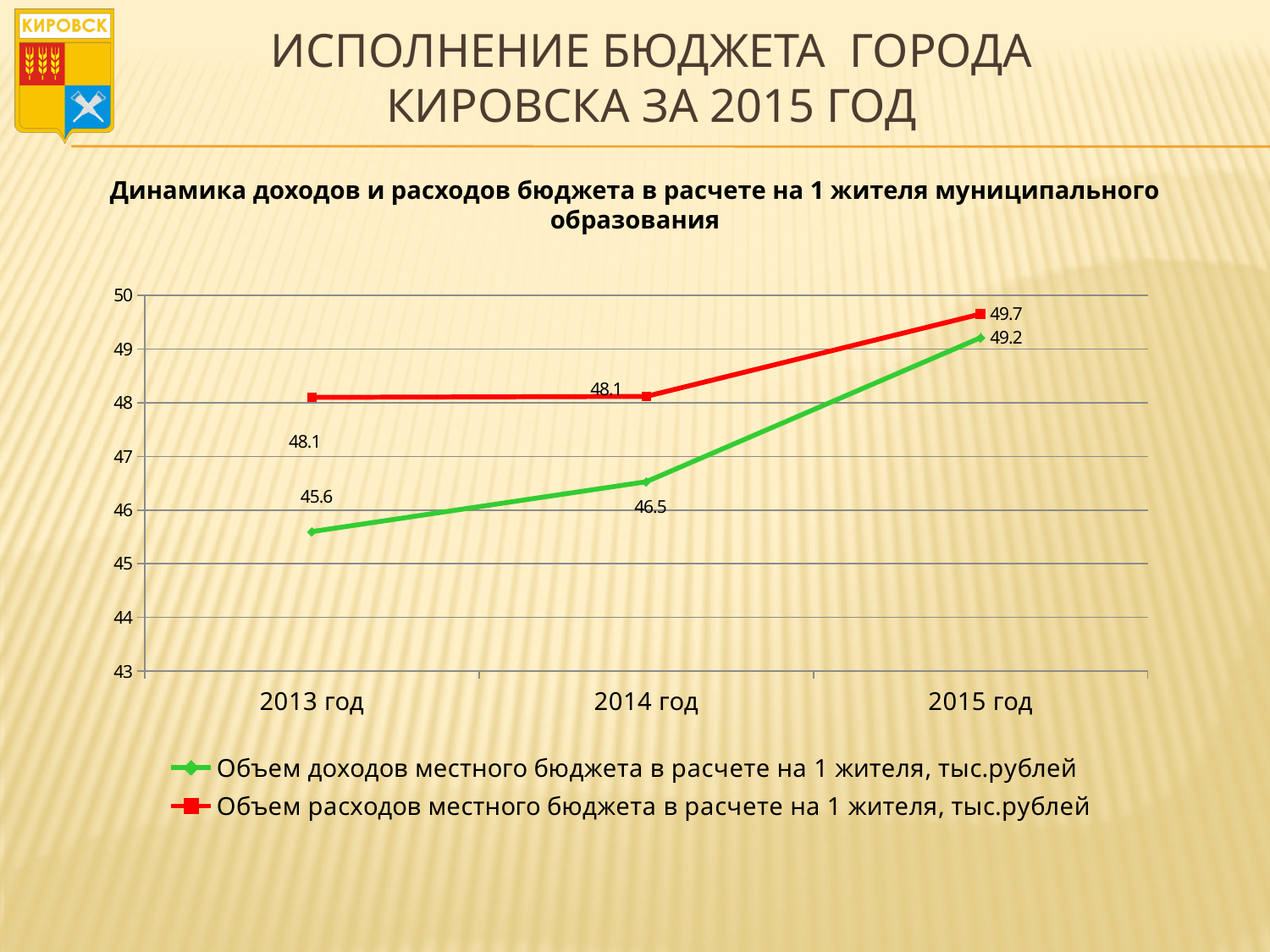
By how much did income per resident increase from 2014 год to 2015 год? 2.7 What is the value of income per resident (Объем доходов местного бюджета в расчете на 1 жителя) in 2013 год? 45.6 How many series does the legend list? 2 What kind of chart is shown on the slide? Line chart In which year is income per resident the lowest? 2013 год Does income per resident rise or fall from 2013 год to 2015 год? Rises What is the value of expenses per resident (Объем расходов местного бюджета в расчете на 1 жителя) in 2015 год? 49.7 What is the value of income per resident in 2014 год? 46.5 What is the difference between expenses and income per resident in 2013 год? 2.5 In which year is income per resident the highest? 2015 год How many years are shown on the x axis? 3 Which is larger in 2015 год: income per resident or expenses per resident? Expenses per resident (49.7)